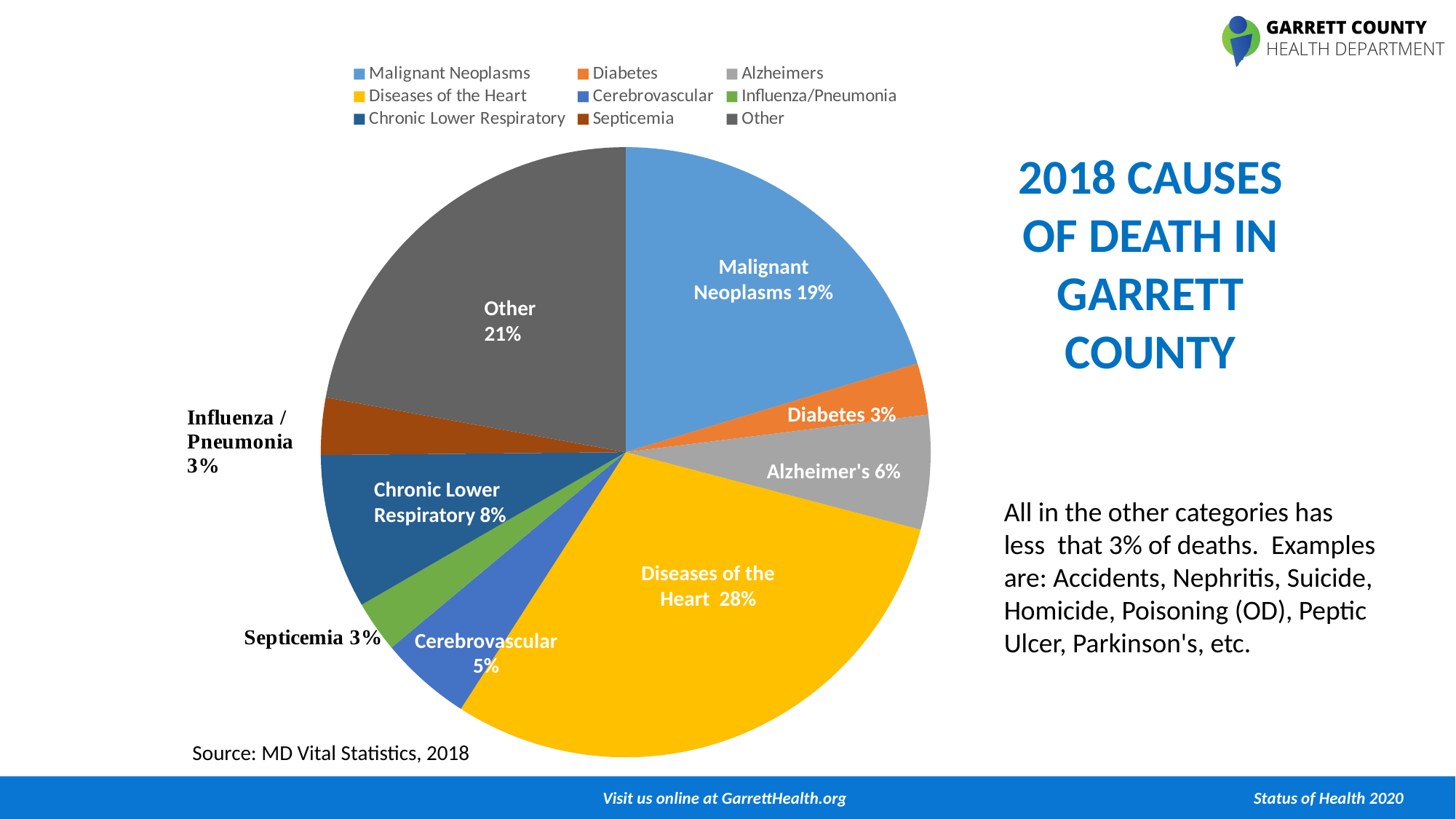
Which named cause of death has the largest share of the pie? Diseases of the Heart What is the difference in percentage points between Diseases of the Heart and Malignant Neoplasms? 9 What is the combined share of Malignant Neoplasms and Diseases of the Heart? 47% Which is larger, the share for Alzheimer's or the share for Cerebrovascular? Alzheimer's What percentage of deaths falls in the Other category? 21% What share of deaths is attributed to Diseases of the Heart? 28% What percentage of deaths is attributed to Diabetes? 3% What percentage of deaths is attributed to Malignant Neoplasms? 19% What is the source cited below the chart? MD Vital Statistics, 2018 How many categories does the legend list? 9 What kind of chart is shown on the slide? pie chart What percentage of deaths is attributed to Chronic Lower Respiratory? 8%